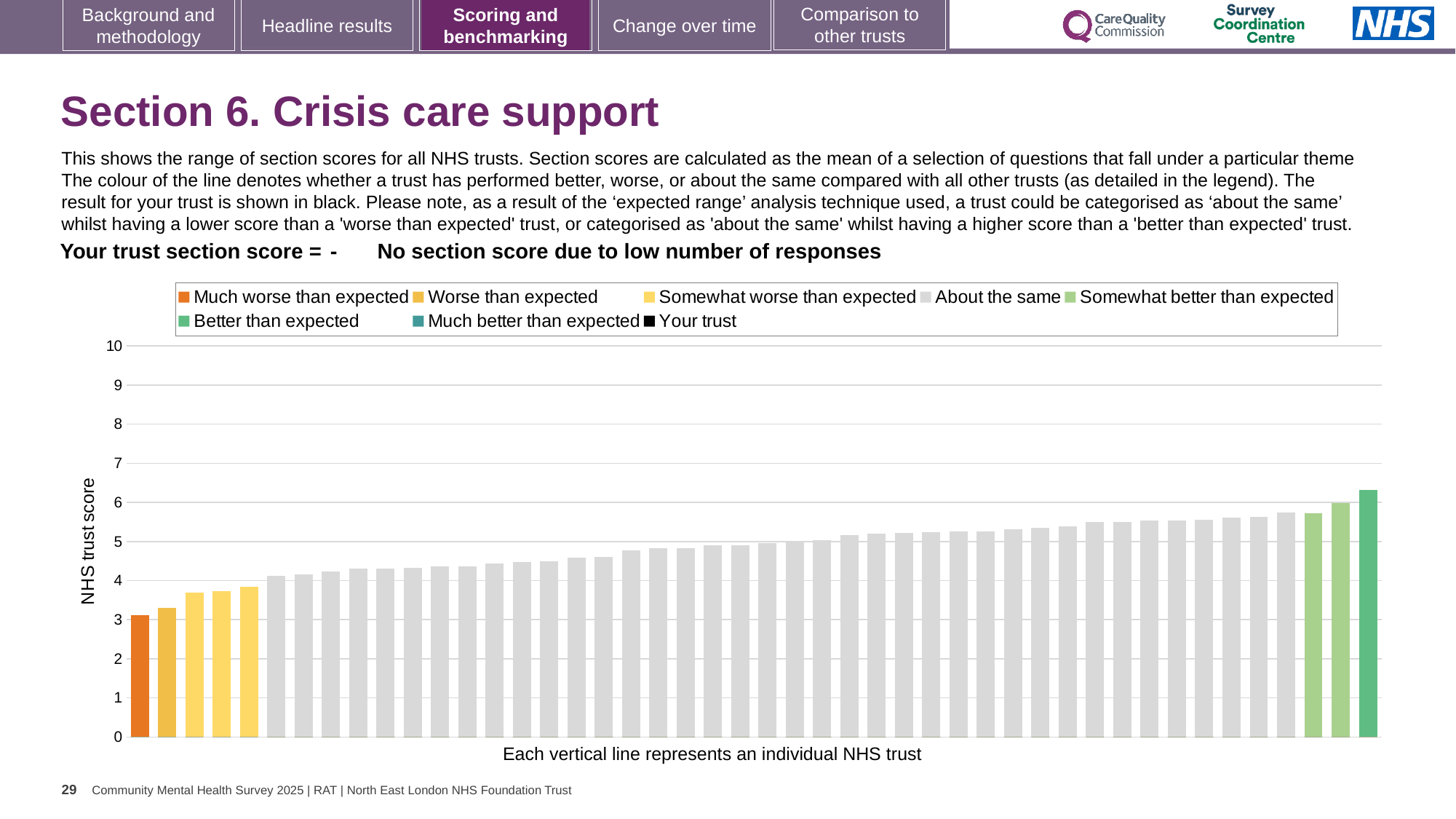
Is the value of the leftmost bar ('Much worse than expected') greater or less than 2? greater What is the highest value shown on the vertical axis? 10 Do the bar heights rise or fall from left to right along the x axis? rise Is the value of the leftmost bar ('Much worse than expected') greater or less than 4? less Is the value of the tallest bar (the rightmost, 'Better than expected' bar) greater or less than 7? less How many bars are coloured as 'Somewhat worse than expected'? 3 How many bars are coloured as 'Much worse than expected'? 1 How many entries does the chart legend list? 8 What is the title of the vertical axis? NHS trust score What kind of chart is shown on the slide? bar chart How many bars are coloured as 'Somewhat better than expected'? 2